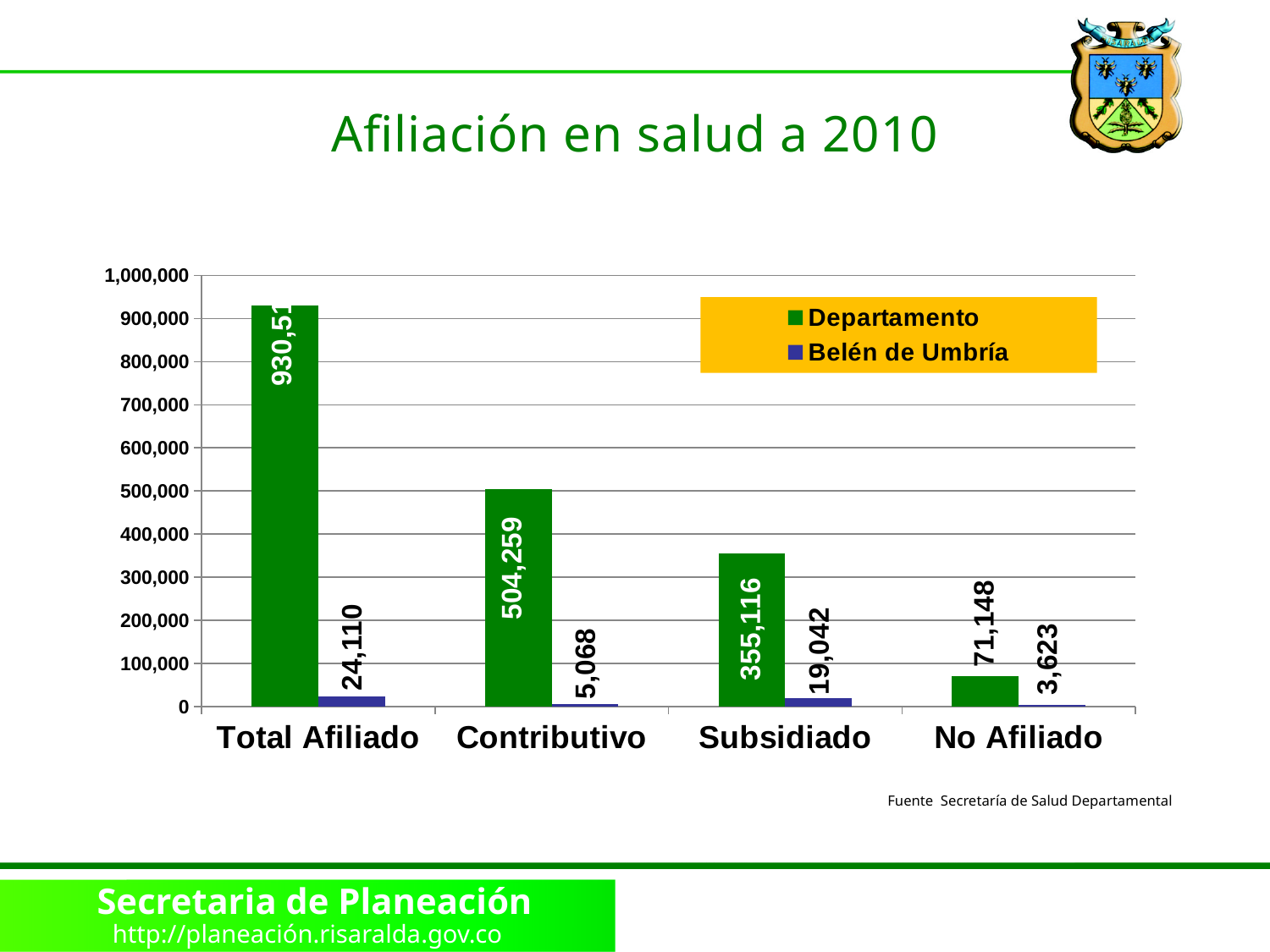
What is the Belén de Umbría value for Total Afiliado? 24,110 Which category has the lowest Departamento value? No Afiliado Is the Departamento value for Total Afiliado greater or less than 900,000? greater How many series does the legend list? 2 What is the Departamento value for No Afiliado? 71,148 What is the Departamento value for Contributivo? 504,259 What is the Belén de Umbría value for Subsidiado? 19,042 What is the difference between the Departamento values for Contributivo and Subsidiado? 149,143 Which category has the highest Belén de Umbría value? Total Afiliado What type of chart is shown on the slide? Bar chart What is the difference between the Belén de Umbría values for Subsidiado and Contributivo? 13,974 Which is larger for Belén de Umbría: Contributivo or Subsidiado? Subsidiado